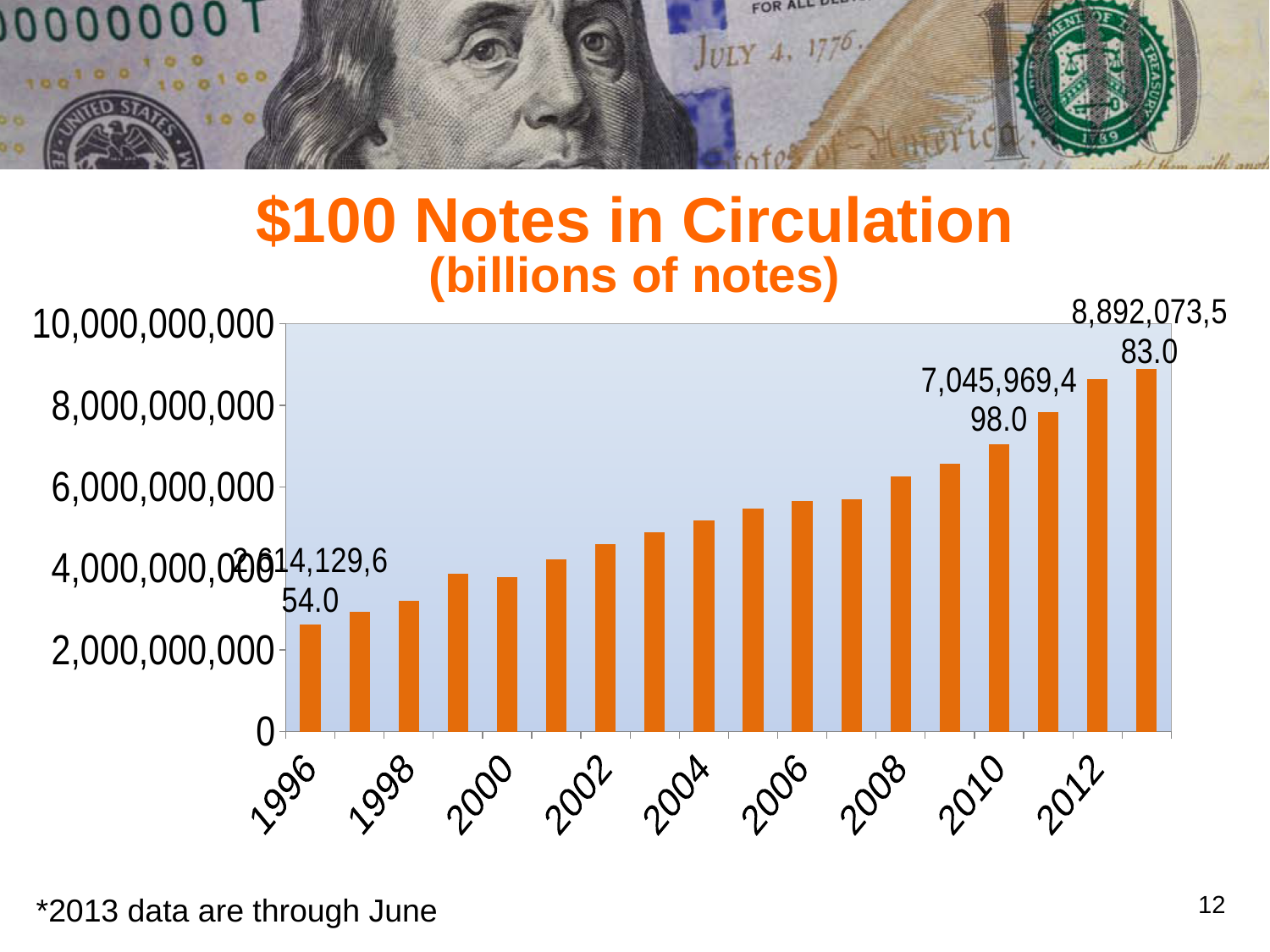
Which year has the highest value in the chart? 2013 What is the title of the chart? $100 Notes in Circulation (billions of notes) Which year has the lowest value in the chart? 1996 Is the value for 2012 greater or less than 8,000,000,000? greater Is the value for 2006 greater or less than 6,000,000,000? less What is the value shown for 2010? 7,045,969,498.0 How many bars (years) are plotted in the chart? 18 Do the values generally rise or fall from 1996 to 2013? rise What is the difference between the 2013 value and the 2010 value? 1,846,104,085.0 What is the value shown for the rightmost bar (2013)? 8,892,073,583.0 Which is larger, the value for 2010 or the value for 2012? 2012 What kind of chart is shown on the slide? bar chart